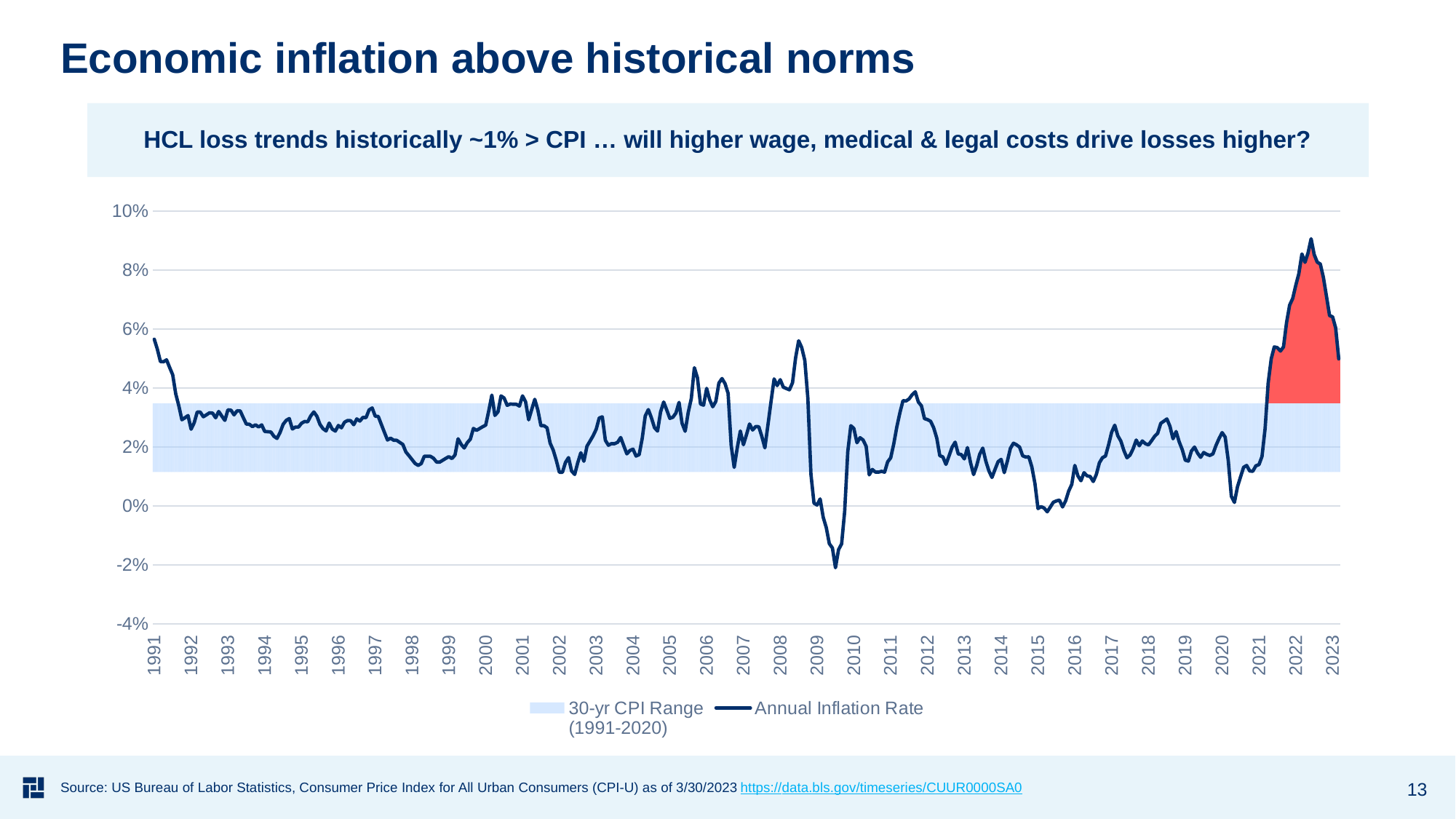
How many series does the chart legend list? 2 In which year does the Annual Inflation Rate reach its lowest point? 2009 What are the two entries in the chart legend? 30-yr CPI Range (1991-2020) and Annual Inflation Rate How many year labels are shown on the x axis? 33 Is the lowest Annual Inflation Rate in 2009 greater or less than 0%? less Is the Annual Inflation Rate at the start of 1991 greater or less than 4%? greater In which year does the Annual Inflation Rate reach its highest peak? 2022 Does the Annual Inflation Rate rise or fall from 2021 to its 2022 peak? rise What kind of chart is shown on the slide? line chart Which is higher, the Annual Inflation Rate peak in 2022 or the peak in 2008? 2022 Is the peak Annual Inflation Rate in 2022 greater or less than 8%? greater What is the highest value shown on the vertical axis? 10%